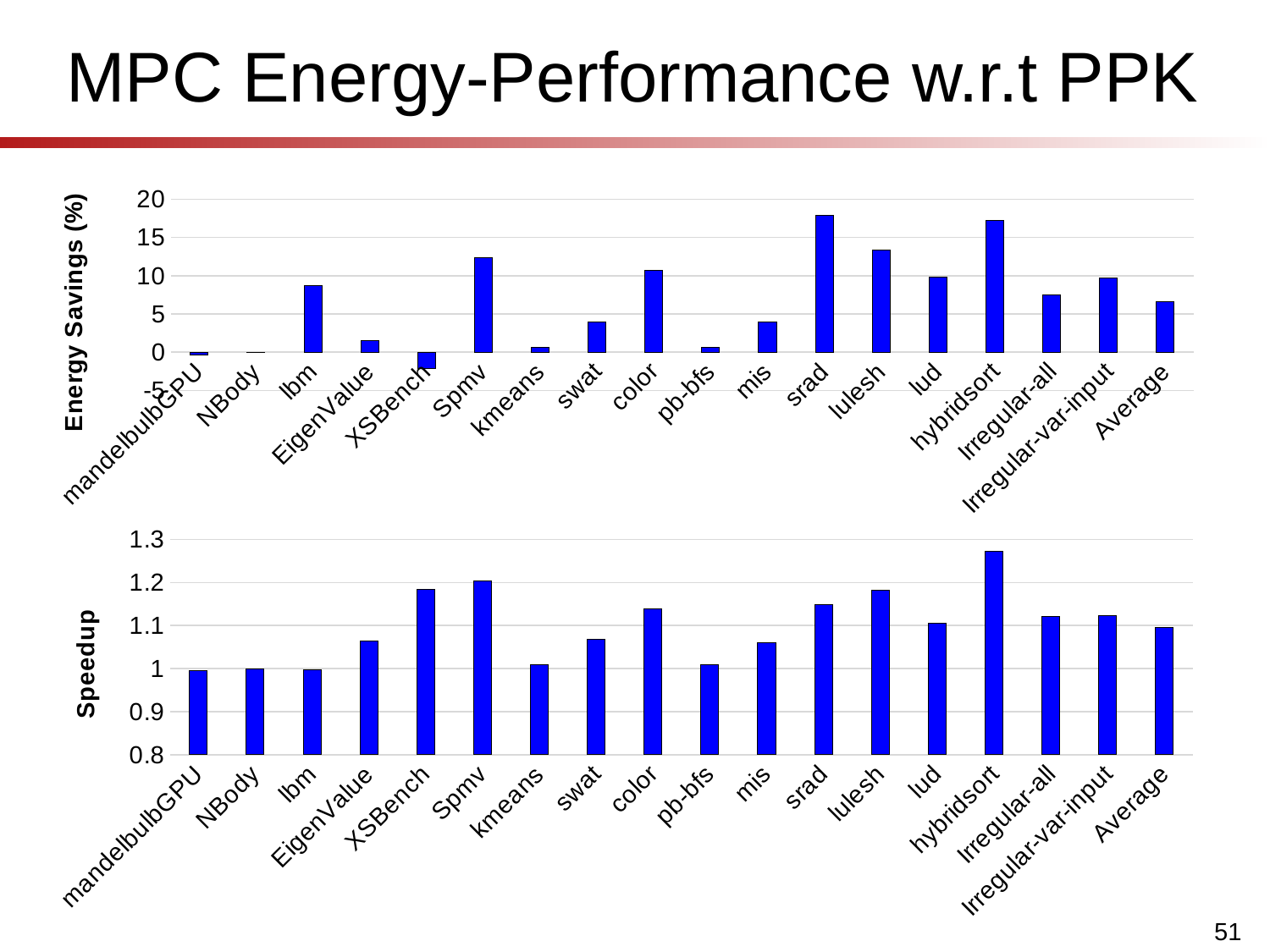
In the top chart (Energy Savings), is the value for lbm greater or less than 5? greater In the top chart (Energy Savings), which is larger, the value for Spmv or the value for color? Spmv In the top chart (Energy Savings), is the value for srad greater or less than 15? greater In the bottom chart (Speedup), is the value for hybridsort greater or less than 1.2? greater In the bottom chart (Speedup), which category has the highest value? hybridsort What is the y-axis label of the top chart? Energy Savings (%) In the top chart (Energy Savings), which category has the lowest value? XSBench What kind of chart is the top chart on the slide (Energy Savings)? bar chart How many categories are shown on the x axis of the bottom chart (Speedup)? 18 In the bottom chart (Speedup), which is larger, the value for XSBench or the value for EigenValue? XSBench